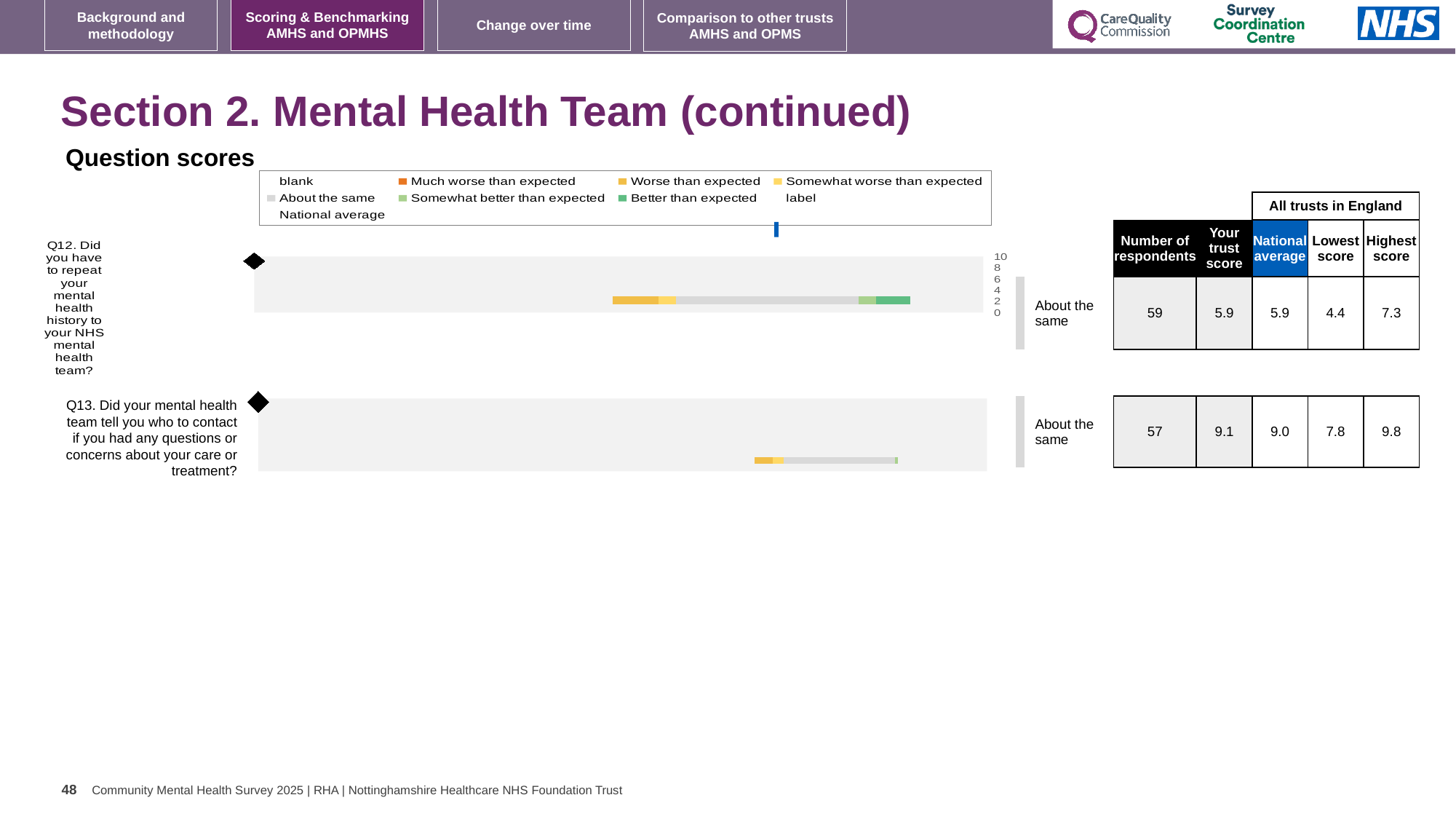
Which colour in the legend represents 'Much worse than expected'? orange What is the highest tick value on the axis shown beside the Q12 bar? 10 What benchmark category label is shown to the right of the Q12 bar? About the same What benchmark category label is shown to the right of the Q13 bar? About the same Which question has the higher trust score, Q12 or Q13? Q13 How many questions are plotted on the slide? 2 According to the table beside the chart, what is the number of respondents for Q12? 59 According to the table beside the chart, what is your trust score for Q13? 9.1 According to the table beside the chart, what is the highest score for Q13? 9.8 What kind of chart is used to show the question scores for Q12 and Q13? bar chart According to the table beside the chart, what is the national average for Q12? 5.9 What is the difference between the highest score and the lowest score for Q12? 2.9